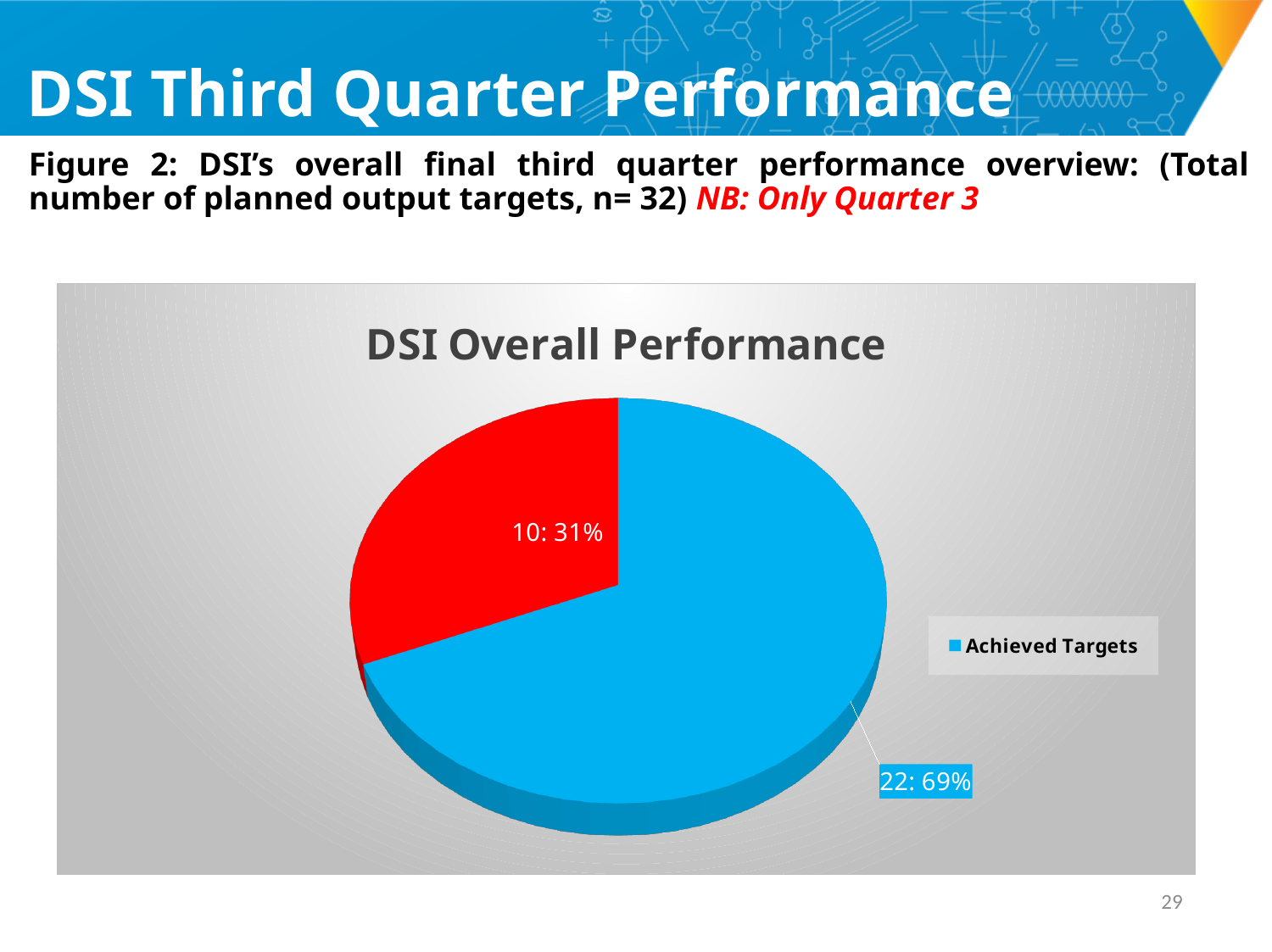
What share of the pie does Achieved Targets represent? 69% How many slices does the pie chart have? 2 What is the title of the chart? DSI Overall Performance Which colour represents Achieved Targets in the pie chart? Blue How many entries does the chart legend list? 1 What is the difference between the Achieved Targets value and the red slice value? 12 What is the total of the two slice values in the pie chart? 32 What is the value shown for Achieved Targets? 22 What value is shown on the red slice of the pie? 10 Which slice is the largest in the pie chart? Achieved Targets What percentage is shown on the red slice of the pie? 31% What kind of chart is shown on the slide? Pie chart